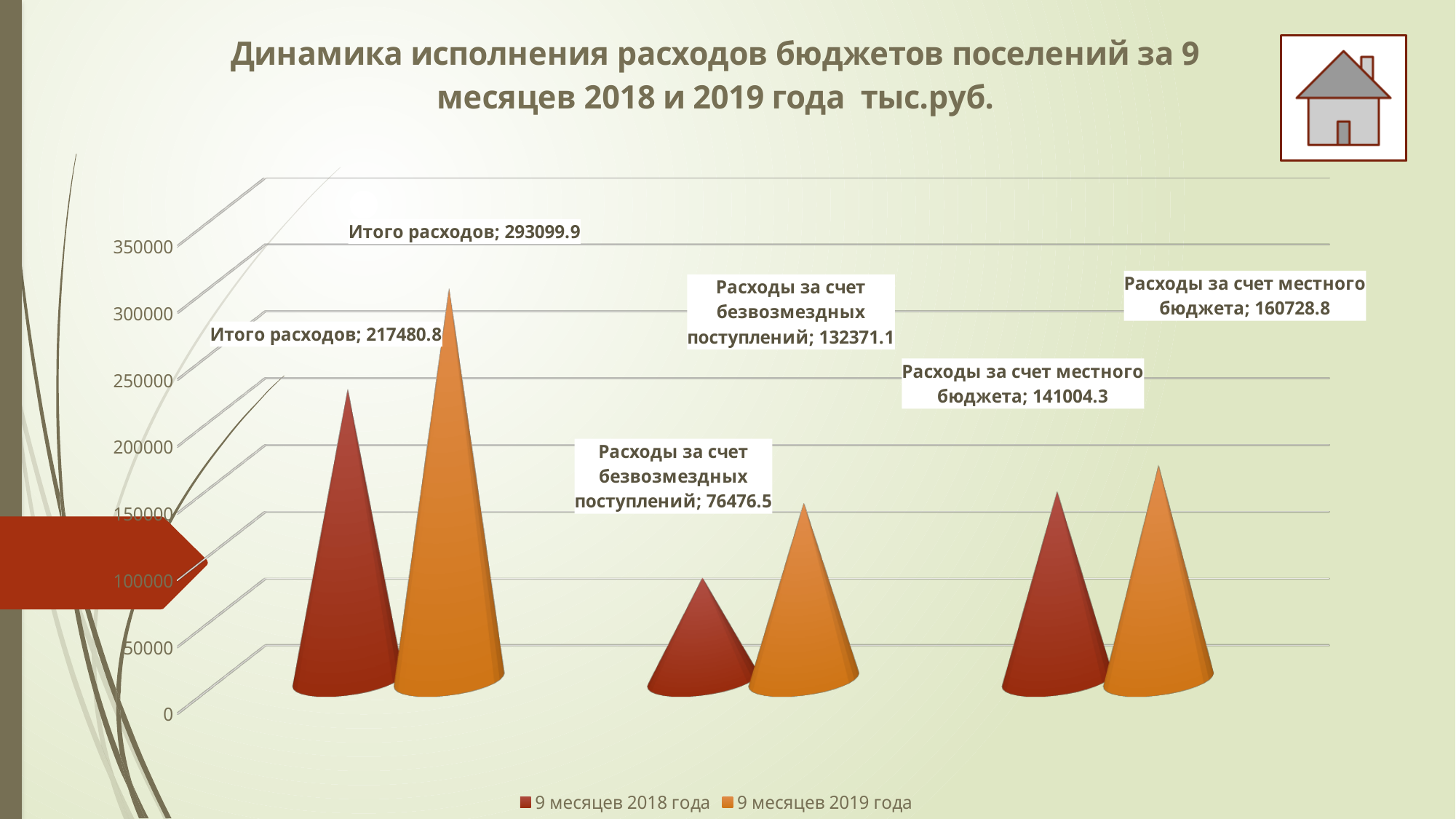
What is the value of 'Расходы за счет безвозмездных поступлений' for '9 месяцев 2018 года'? 76476.5 What is the value of 'Расходы за счет местного бюджета' for '9 месяцев 2019 года'? 160728.8 How many series does the legend list? 2 What is the value of 'Расходы за счет местного бюджета' for '9 месяцев 2018 года'? 141004.3 What is the value of 'Итого расходов' for '9 месяцев 2018 года'? 217480.8 What is the difference between 'Итого расходов' for 2019 (293099.9) and for 2018 (217480.8)? 75619.1 How many categories are shown in the chart? 3 Which category has the highest value for '9 месяцев 2019 года'? Итого расходов What is the value of 'Итого расходов' for '9 месяцев 2019 года'? 293099.9 Which is larger: 'Расходы за счет безвозмездных поступлений' for 2018 or for 2019? 9 месяцев 2019 года Which category has the lowest value for '9 месяцев 2018 года'? Расходы за счет безвозмездных поступлений What is the title of the chart? Динамика исполнения расходов бюджетов поселений за 9 месяцев 2018 и 2019 года тыс.руб.